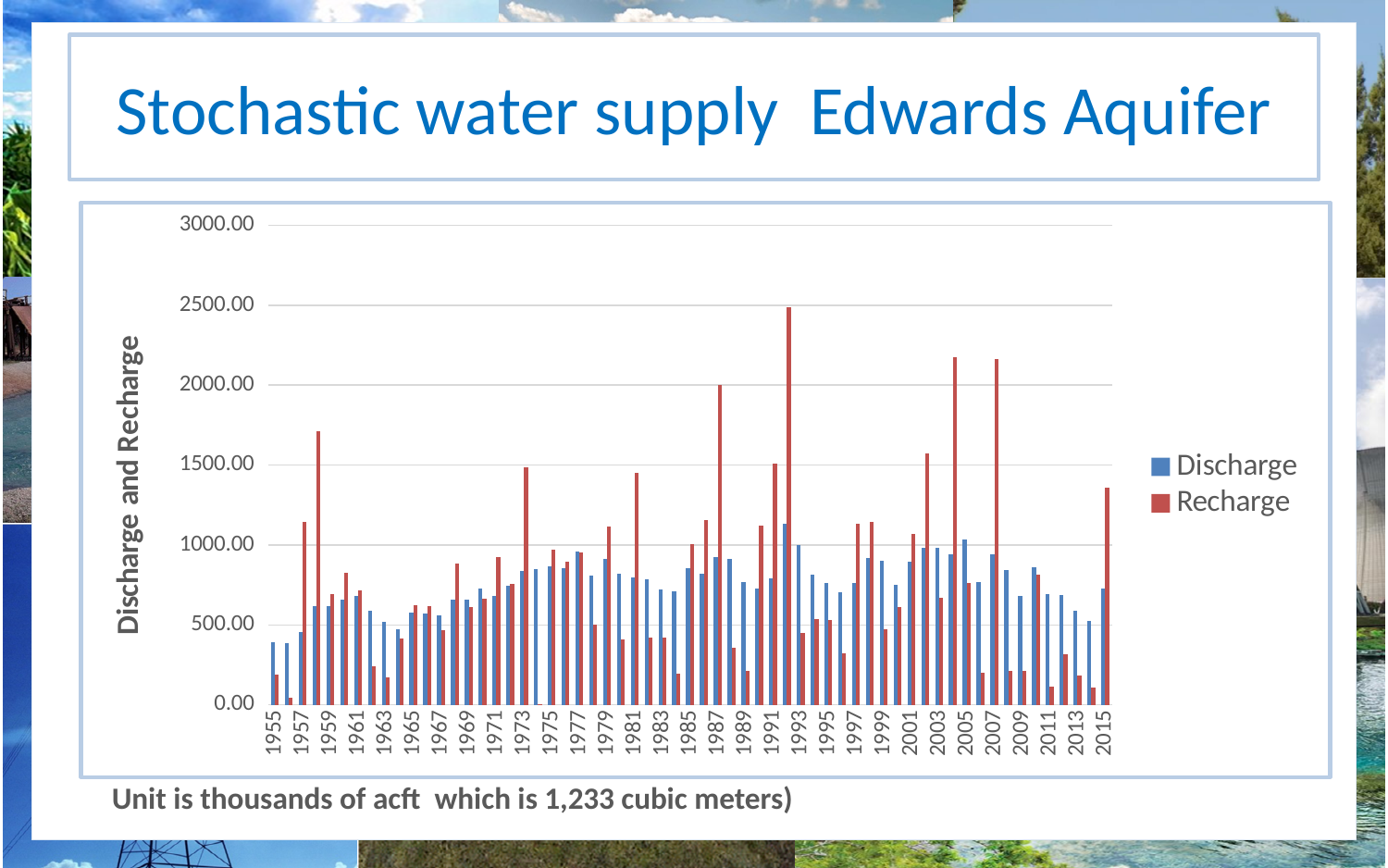
Is the Recharge value for 1958 greater or less than 1500.00? greater Is the Recharge value for 1992 greater or less than 2000.00? greater What are the two series shown in the legend? Discharge and Recharge In 1992, which is larger, Discharge or Recharge? Recharge In 2011, which is larger, Discharge or Recharge? Discharge Is the Discharge value for 1955 greater or less than 500.00? less In which year is the Recharge value highest? 1992 What is the title of the vertical axis? Discharge and Recharge In which year is the Recharge value lowest? 1974 How many series does the legend list? 2 What kind of chart is shown on the slide? bar chart